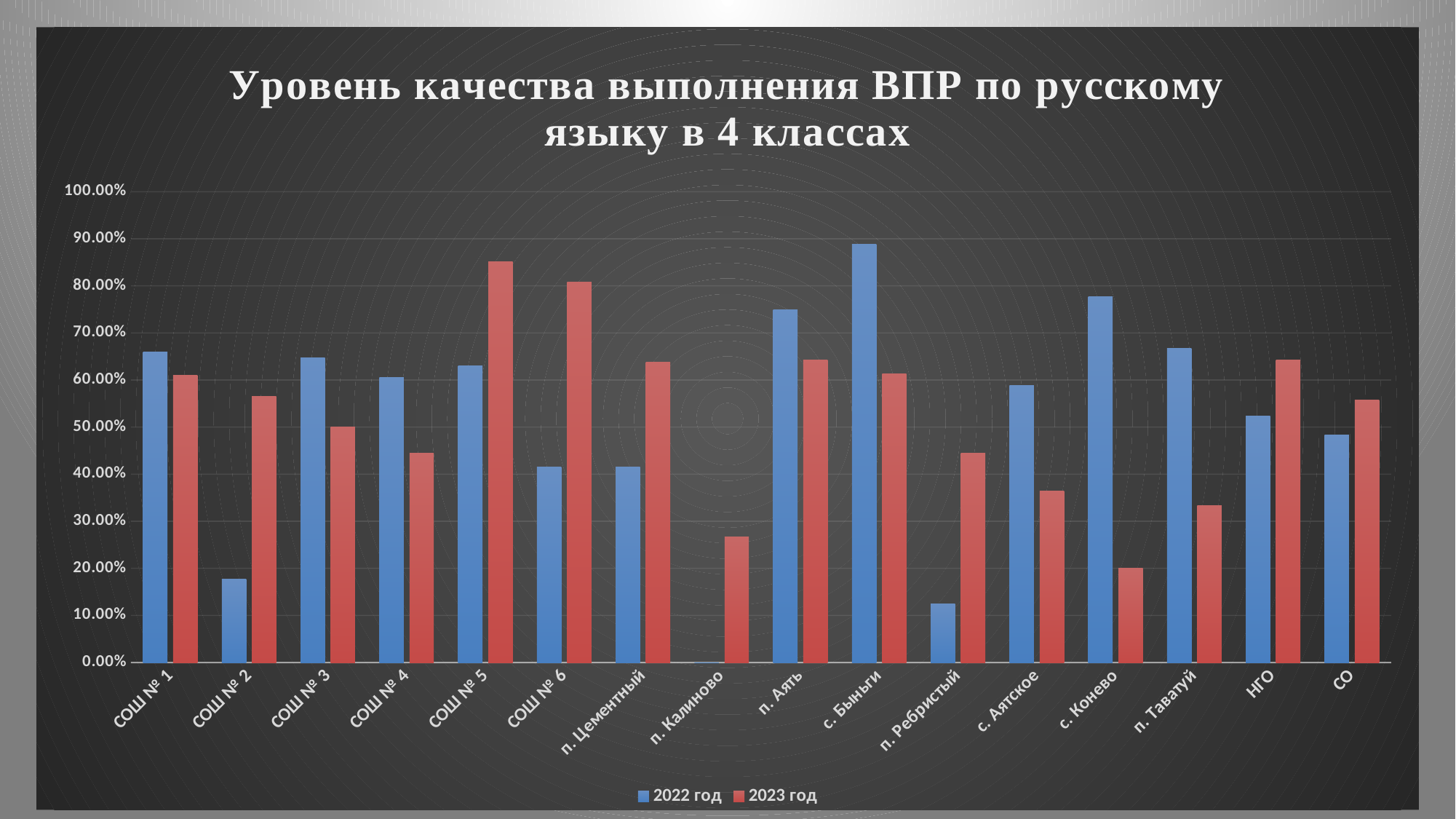
What kind of chart is shown on the slide? bar chart Is the 2023 год value for СОШ № 5 greater or less than 80.00%? greater Which category has the lowest value for the 2023 год series? с. Конево What is the title of the chart? Уровень качества выполнения ВПР по русскому языку в 4 классах For СОШ № 6, which series has the larger value, 2022 год or 2023 год? 2023 год Which category has the highest value for the 2022 год series? с. Быньги Which category has the highest value for the 2023 год series? СОШ № 5 How many series does the legend list? 2 How many categories are shown on the x axis? 16 Is the 2022 год value for СОШ № 2 greater or less than 20.00%? less